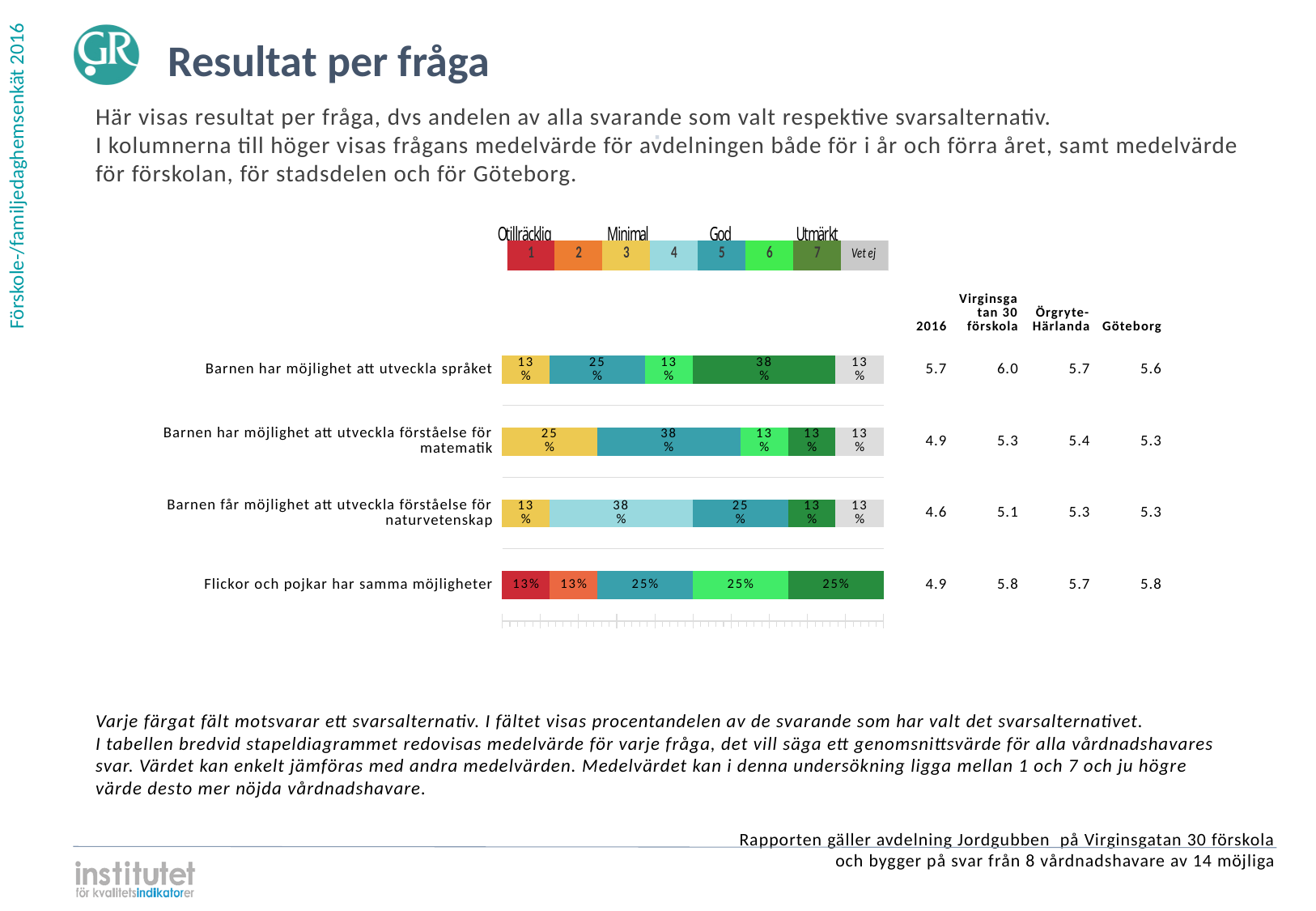
What is the 2016 mean value for 'Barnen har möjlighet att utveckla förståelse för matematik'? 4.9 How many answer alternatives does the legend above the chart list? 8 What is the difference between the share of answer 7 and the share of answer 3 for 'Barnen har möjlighet att utveckla språket'? 25 percentage points What percentage of respondents chose answer 7 (Utmärkt) for 'Barnen har möjlighet att utveckla språket'? 38% What kind of chart is shown on the slide? Stacked bar chart What percentage chose answer 1 (Otillräcklig) for 'Flickor och pojkar har samma möjligheter'? 13% Which question has the largest share of answer 7 (Utmärkt)? Barnen har möjlighet att utveckla språket Which question has the lowest mean value in the 2016 column? Barnen får möjlighet att utveckla förståelse för naturvetenskap Is the Göteborg mean for 'Flickor och pojkar har samma möjligheter' larger or smaller than the 2016 mean for the same question? larger How many questions (bars) are shown in the chart? 4 What percentage chose answer 4 for 'Barnen får möjlighet att utveckla förståelse för naturvetenskap'? 38% Which question has no 'Vet ej' segment in its bar? Flickor och pojkar har samma möjligheter